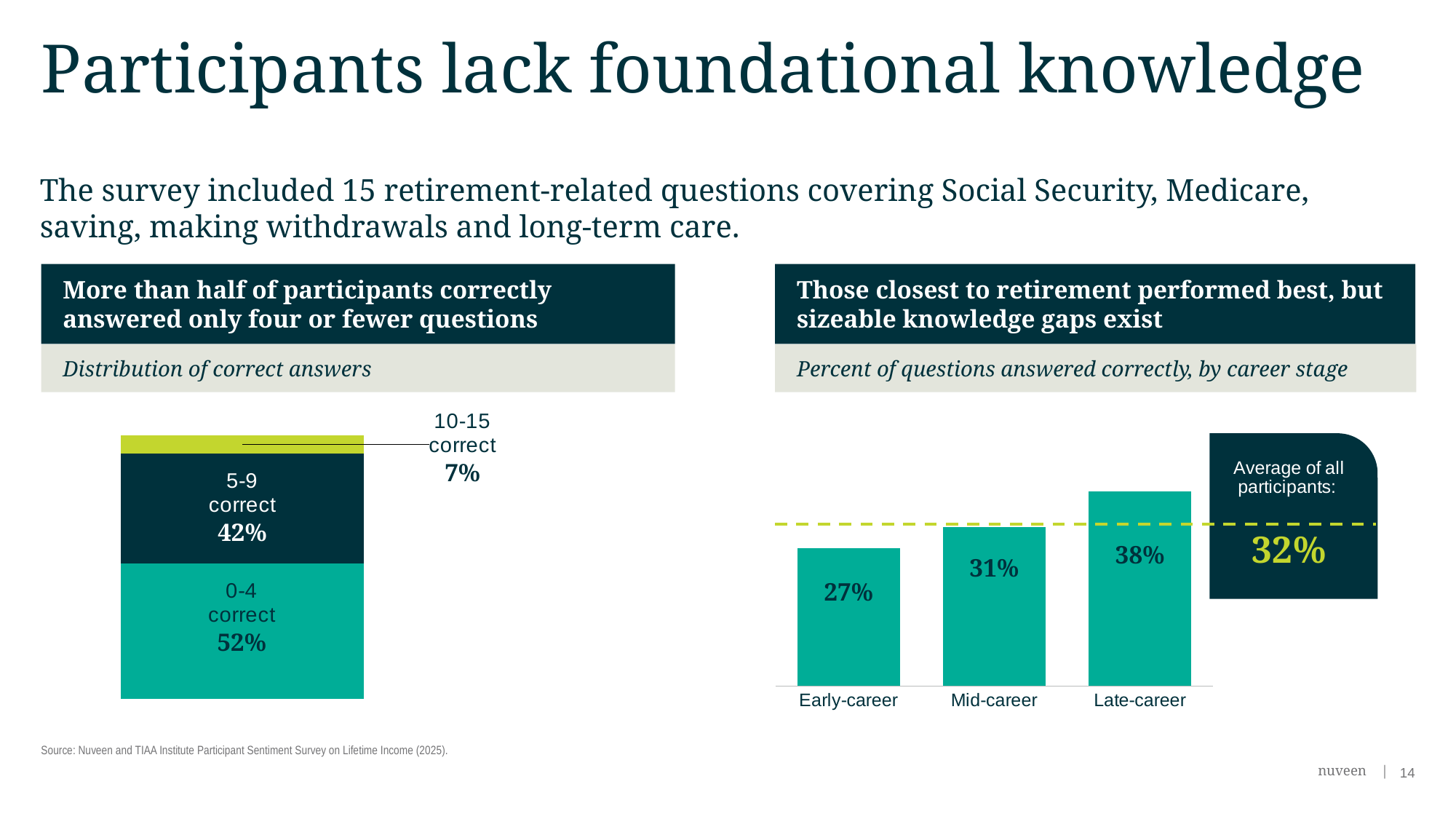
In the 'Percent of questions answered correctly, by career stage' chart, what is the average of all participants shown by the dashed line? 32% In the 'Percent of questions answered correctly, by career stage' chart, do the values rise or fall from Early-career to Late-career? rise In the 'Distribution of correct answers' chart, which segment is the smallest? 10-15 correct In the 'Distribution of correct answers' chart, what share of participants answered 0-4 questions correctly? 52% In the 'Percent of questions answered correctly, by career stage' chart, what is the value for Mid-career? 31% In the 'Distribution of correct answers' chart, what share of participants answered 10-15 questions correctly? 7% In the 'Distribution of correct answers' chart, what share of participants answered 5-9 questions correctly? 42% In the 'Distribution of correct answers' chart, how many segments make up the stacked bar? 3 In the 'Percent of questions answered correctly, by career stage' chart, what is the value for Early-career? 27% In the 'Percent of questions answered correctly, by career stage' chart, what is the difference between Late-career and Early-career? 11 percentage points In the 'Percent of questions answered correctly, by career stage' chart, which career stage has the highest value? Late-career In the 'Distribution of correct answers' chart, which segment is the largest? 0-4 correct